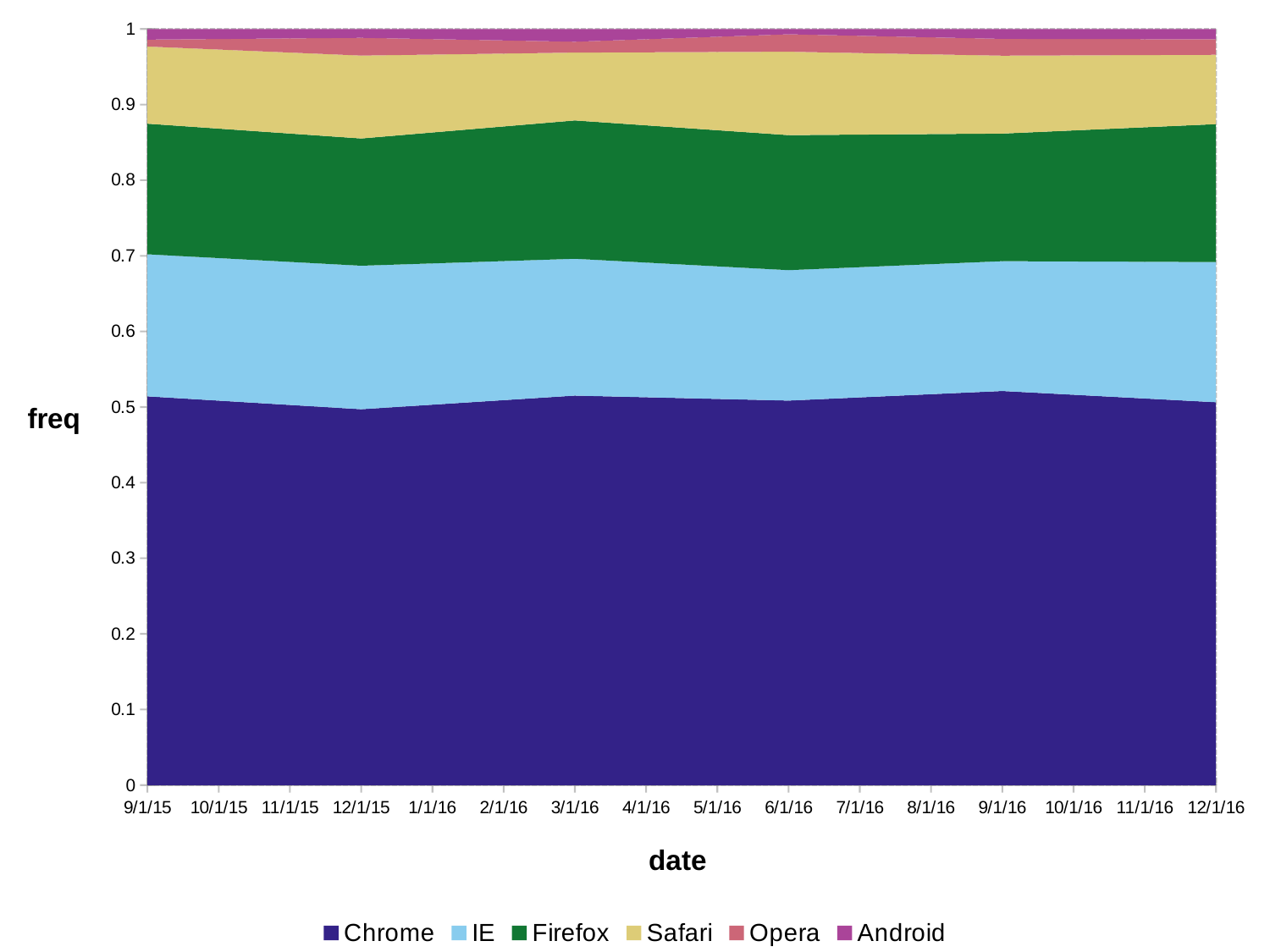
What kind of chart is shown on the slide? stacked area chart Which series occupies the largest share of the chart area? Chrome Is the value for Chrome on 9/1/16 greater or less than 0.5? greater What is the label on the y axis? freq How many dates are labelled along the x axis? 16 Is the cumulative top of the Firefox band on 9/1/15 greater or less than 0.8? greater How many series does the legend list? 6 Is the value for Chrome on 9/1/15 greater or less than 0.4? greater What is the first date shown on the x axis? 9/1/15 Which series occupies the smallest share of the chart area? Android Which series is larger, Chrome or IE? Chrome